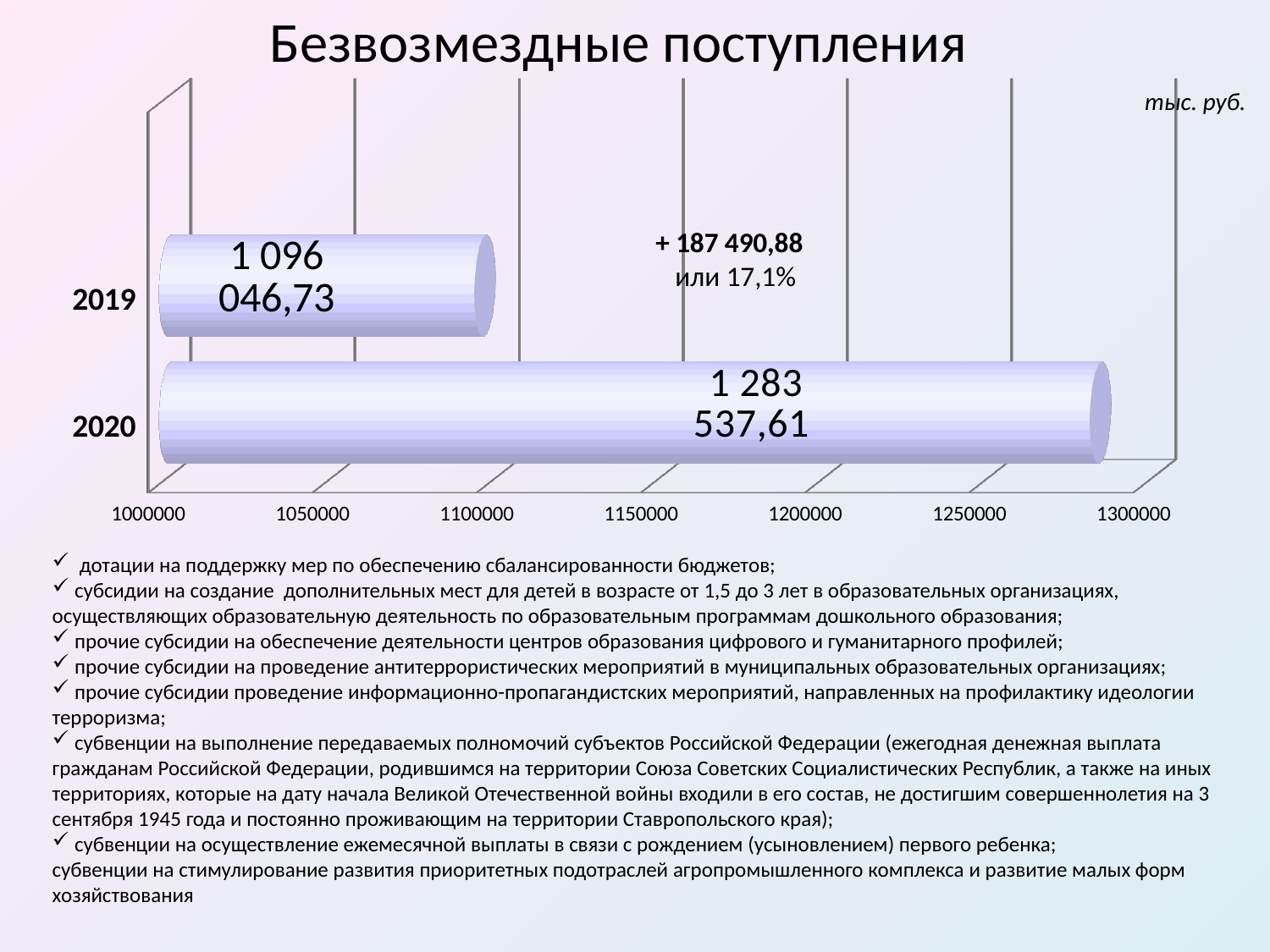
What is the difference between the 2020 and 2019 values? 187 490,88 Is the value for 2019 greater or less than 1150000? less How many years are shown in the chart? 2 What is the title of the chart? Безвозмездные поступления What is the value for 2020? 1 283 537,61 What is the value for 2019? 1 096 046,73 In what units are the chart values given? тыс. руб. What kind of chart is shown on the slide? Bar chart Which year has the lower value? 2019 Which year has the higher value? 2020 Is the value for 2020 greater or less than 1250000? greater Is the value for 2020 larger than the value for 2019? Yes